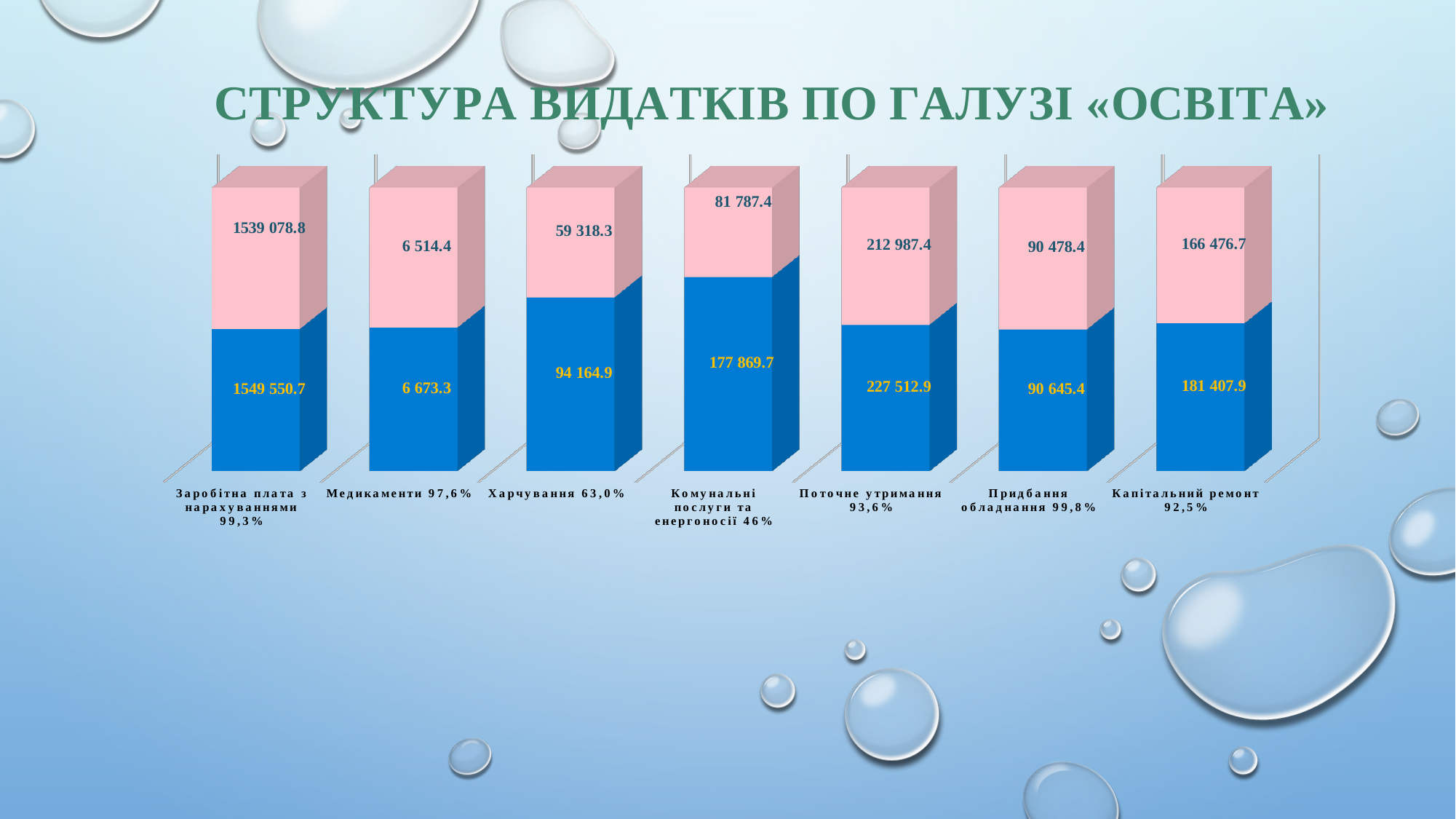
How many categories are shown on the x axis of the chart? 7 What is the difference between the blue and pink segment values for «Харчування 63,0%»? 34 846.6 Which category has the highest blue segment value? Заробітна плата з нарахуваннями 99,3% What kind of chart is shown on the slide? stacked bar chart What is the value of the blue segment for «Харчування 63,0%»? 94 164.9 What is the difference between the blue and pink segment values for «Комунальні послуги та енергоносії 46%»? 96 082.3 What is the value of the pink segment for «Медикаменти 97,6%»? 6 514.4 What is the value of the pink segment for «Поточне утримання 93,6%»? 212 987.4 What is the title of the chart on the slide? СТРУКТУРА ВИДАТКІВ ПО ГАЛУЗІ «ОСВІТА» Which category has the lowest pink segment value? Медикаменти 97,6% For «Капітальний ремонт 92,5%», which segment has the larger value, the blue or the pink one? blue What is the value of the blue segment for «Комунальні послуги та енергоносії 46%»? 177 869.7